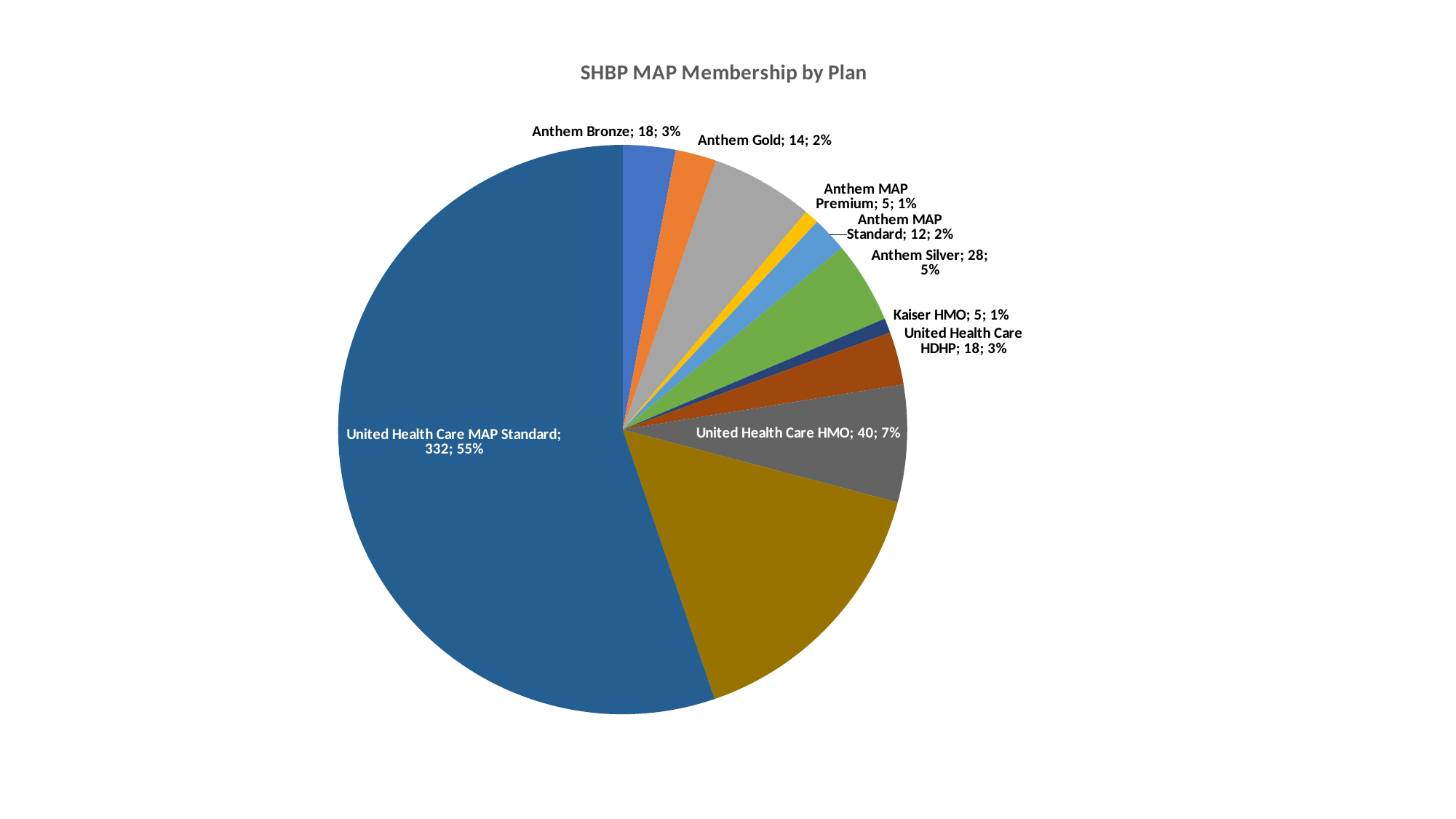
How many members are in the Anthem Gold plan? 14 Which plan has the largest slice of the pie? United Health Care MAP Standard How many members are in the United Health Care MAP Standard plan? 332 What share of the pie does United Health Care MAP Standard represent? 55% What percentage of membership is in Anthem Silver? 5% Which has more members, Anthem Silver or Anthem Gold? Anthem Silver What is the difference in members between United Health Care HMO and Anthem Silver? 12 How many members are in the United Health Care HMO plan? 40 How many slices does the pie chart have? 11 What share of the pie does Kaiser HMO represent? 1% What type of chart is shown on the slide? pie chart What is the title of the chart? SHBP MAP Membership by Plan